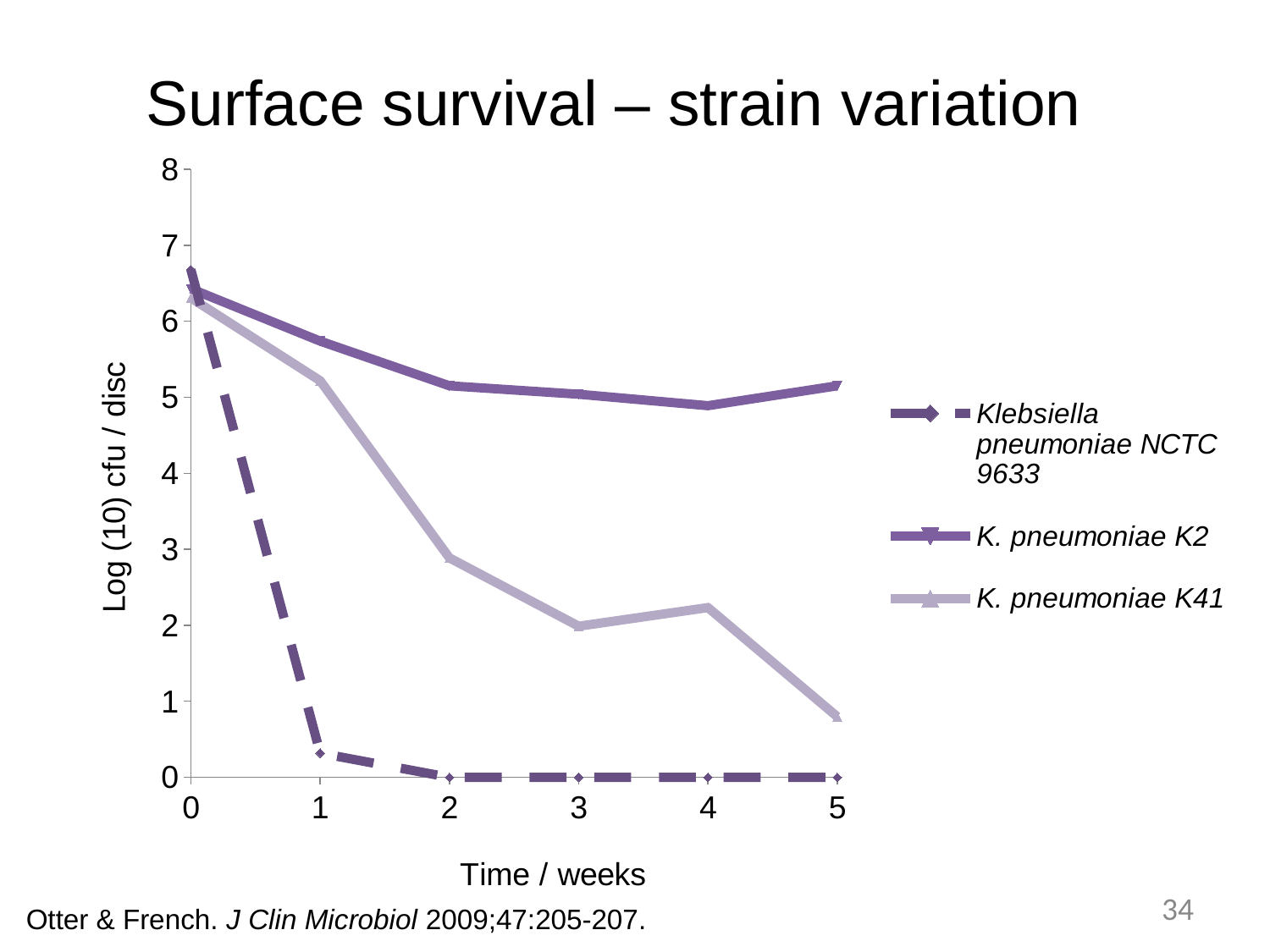
Is the value for K. pneumoniae K2 at week 5 greater or less than 4? greater What is the label on the y axis? Log (10) cfu / disc Do the values for K. pneumoniae K41 rise or fall from week 0 to week 5? fall Which series has the highest value at week 5? K. pneumoniae K2 How many series does the legend list? 3 At week 3, which is larger: K. pneumoniae K2 or K. pneumoniae K41? K. pneumoniae K2 How many time points are plotted for each series? 6 Is the value for Klebsiella pneumoniae NCTC 9633 at week 1 greater or less than 1? less What is the value for Klebsiella pneumoniae NCTC 9633 at week 3? 0 Is the value for K. pneumoniae K41 at week 5 greater or less than 2? less What kind of chart is shown on the slide? line chart Which series has the lowest value at week 5? Klebsiella pneumoniae NCTC 9633